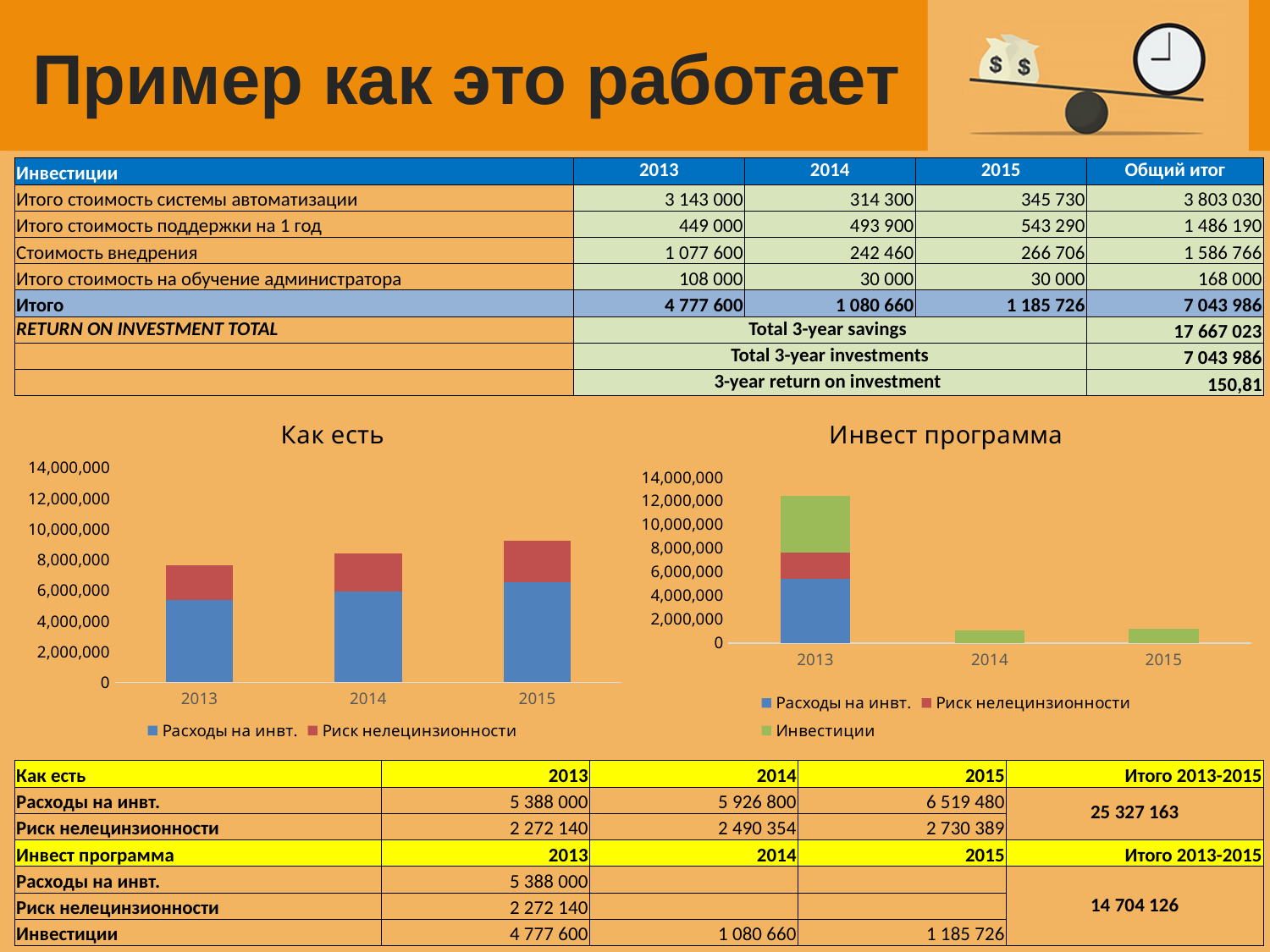
In the "Как есть" chart, which year has the tallest stacked bar? 2015 Which series appears only in the "Инвест программа" chart and not in the "Как есть" chart? Инвестиции In the "Инвест программа" chart, is the total of the 2013 bar greater or less than 10,000,000? greater How many series does the legend of the "Инвест программа" chart list? 3 What kind of chart is the "Как есть" chart? stacked bar chart How many series does the legend of the "Как есть" chart list? 2 In the "Инвест программа" chart, which year has the tallest stacked bar? 2013 In the "Как есть" chart, do the stacked bar totals rise or fall from 2013 to 2015? rise In the "Инвест программа" chart, is the total of the 2014 bar greater or less than 2,000,000? less In the "Как есть" chart, which year has the shortest stacked bar? 2013 How many years are shown on the x axis of the "Как есть" chart? 3 In the "Как есть" chart, is the "Расходы на инвт." value for 2013 greater or less than 4,000,000? greater